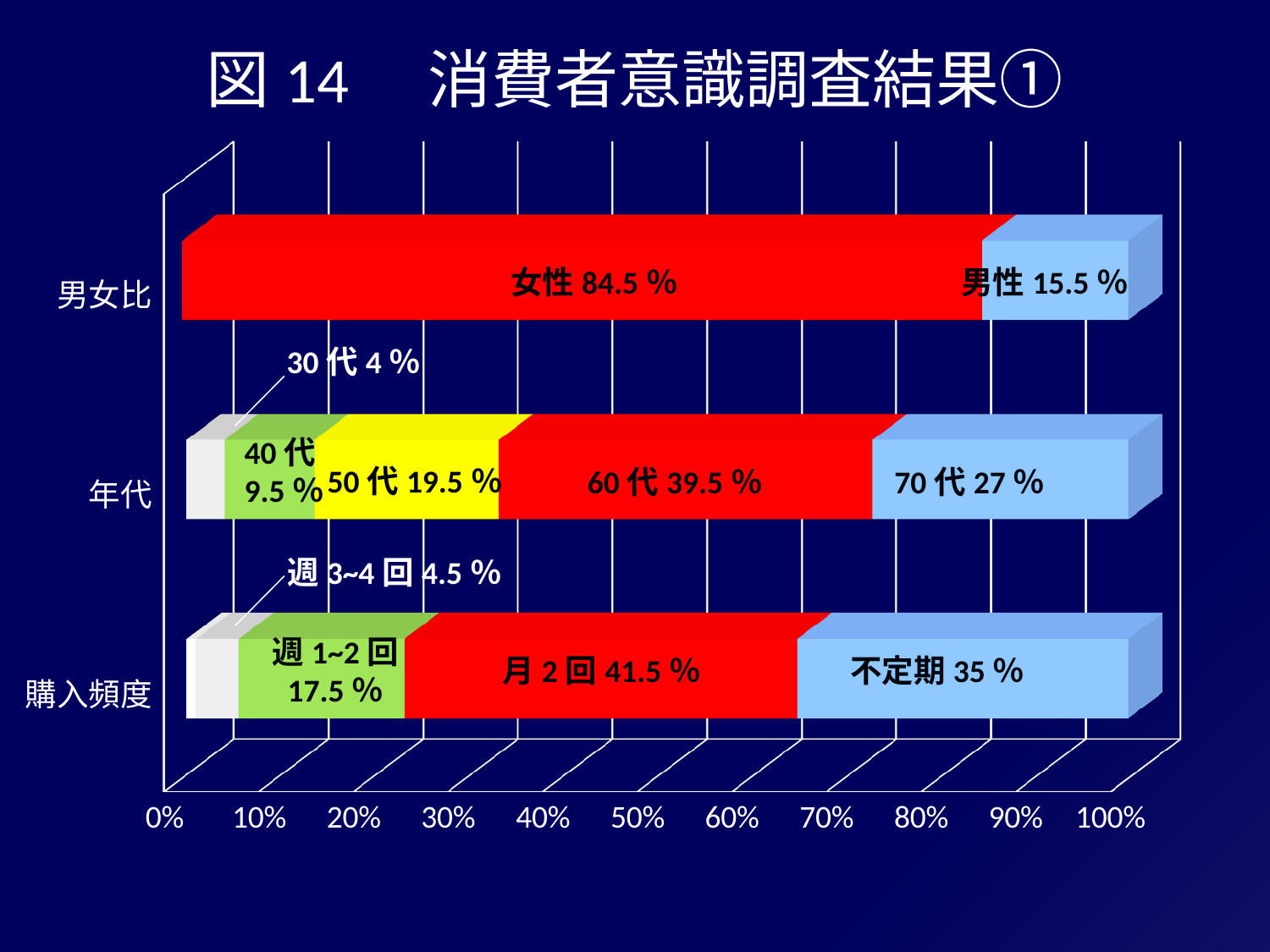
What is the value for 不定期 in the 購入頻度 bar? 35 % What is the combined share of 週 3~4 回 and 週 1~2 回 in the 購入頻度 bar? 22 % What is the value for 60 代 in the 年代 bar? 39.5 % What is the title of the slide? 図 14 消費者意識調査結果① Which segment is the largest in the 購入頻度 bar? 月 2 回 How many category bars are shown in the chart? 3 What is the value for 女性 in the 男女比 bar? 84.5 % Which is larger in the 年代 bar, 70 代 or 50 代? 70 代 What is the value for 男性 in the 男女比 bar? 15.5 % Which age group has the smallest share in the 年代 bar? 30 代 What is the difference between 女性 and 男性 in the 男女比 bar? 69 % What kind of chart is shown on the slide? Stacked bar chart